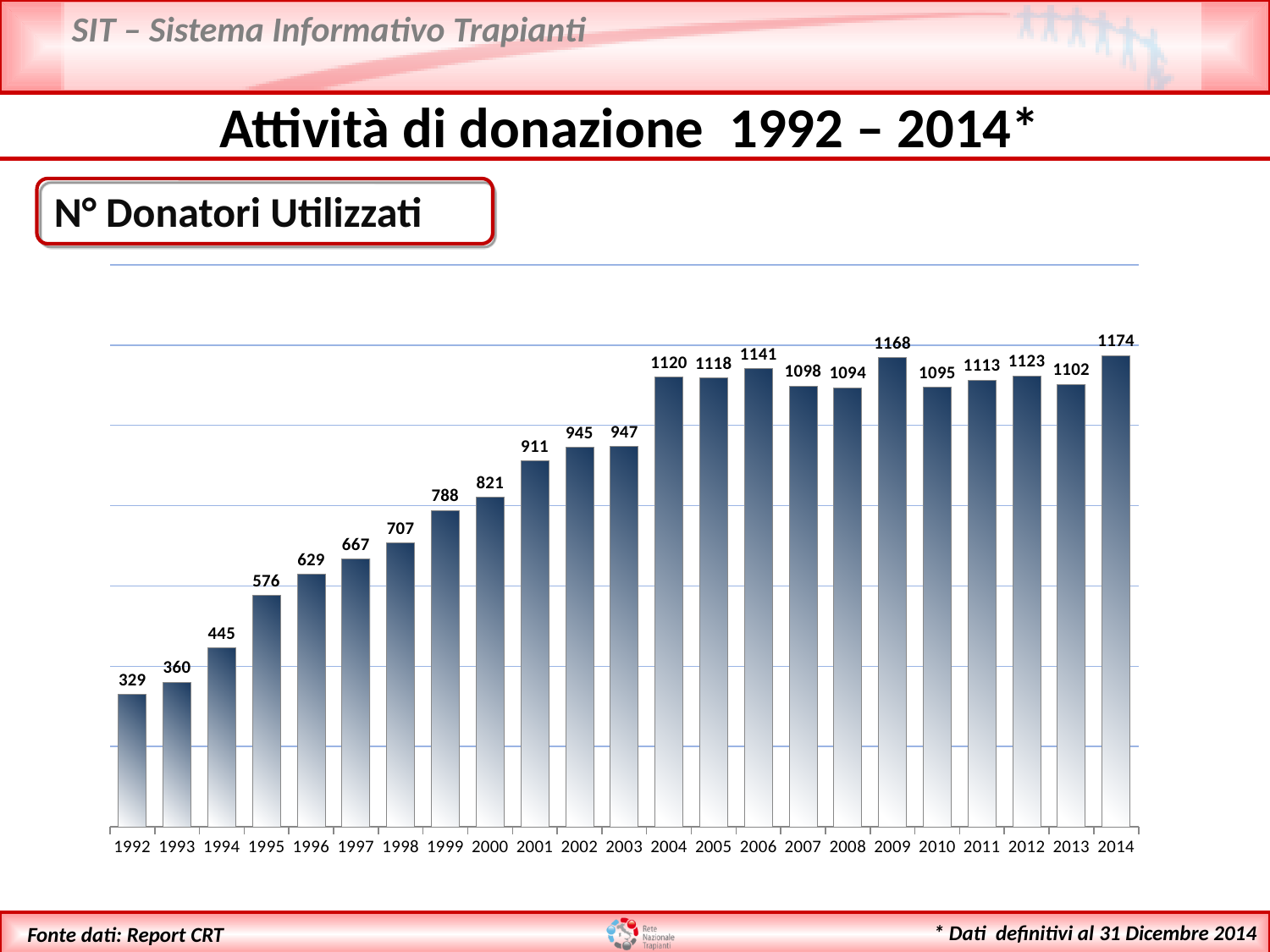
What kind of chart is used to show the number of donors used? Bar chart Which year has the highest number of donors used? 2014 What is the value shown for 2003? 947 What is the difference between the values for 2014 and 1992? 845 Which year has a larger value, 1999 or 2000? 2000 Do the values generally rise or fall from 1992 to 2004? Rise What is the number of donors used (N° Donatori Utilizzati) in 1992? 329 How many years are shown on the x axis of the chart? 23 Which year has the lowest number of donors used? 1992 What is the value shown for 2009? 1168 What is the difference between the values for 2006 and 2007? 43 Which year has a larger value, 2004 or 2005? 2004